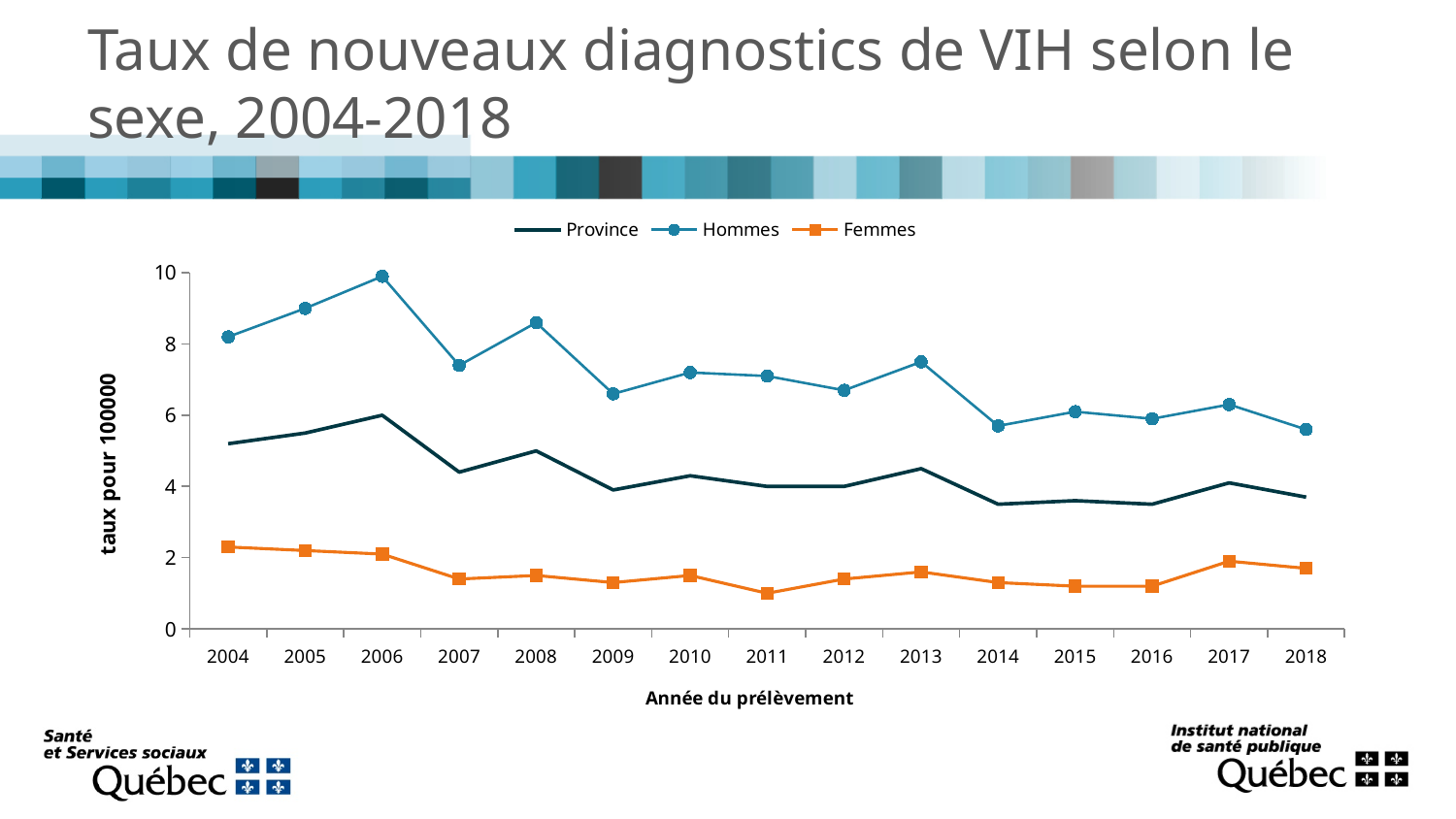
In which year is the Hommes series at its highest? 2006 Which series is higher in 2010, Hommes or Femmes? Hommes Is the value for Hommes in 2006 greater or less than 8? greater How many years are plotted along the x axis? 15 Is the value for Femmes in 2011 greater or less than 2? less How many series does the legend list? 3 In which year is the Province series at its highest? 2006 In which year is the Femmes series at its lowest? 2011 Is the value for Province in 2006 greater or less than 4? greater What kind of chart is shown on the slide? line chart What is the title of the x axis? Année du prélèvement Does the Hommes series overall rise or fall from 2004 to 2018? fall